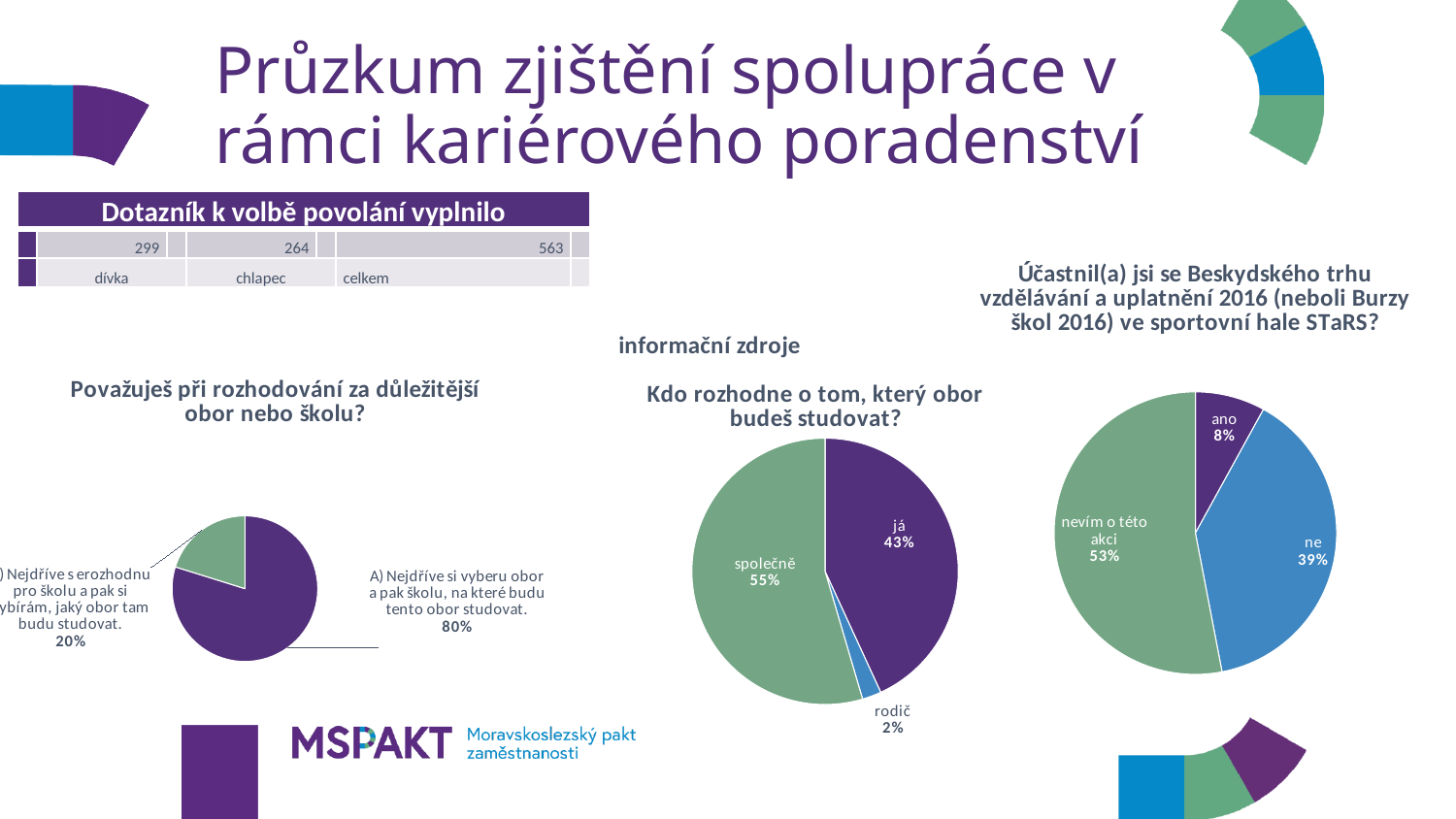
In the chart 'Kdo rozhodne o tom, který obor budeš studovat?', what share is labelled 'společně'? 55% In the chart 'Považuješ při rozhodování za důležitější obor nebo školu?', what share is given for option A (Nejdříve si vyberu obor a pak školu)? 80% What kind of chart is 'Kdo rozhodne o tom, který obor budeš studovat?'? pie chart In the chart 'Účastnil(a) jsi se Beskydského trhu vzdělávání a uplatnění 2016...', which category has the smallest share? ano In the chart 'Kdo rozhodne o tom, který obor budeš studovat?', what share is labelled 'rodič'? 2% In the chart 'Dotazník k volbě povolání vyplnilo', what is the difference between 'dívka' and 'chlapec'? 35 In the chart 'Považuješ při rozhodování za důležitější obor nebo školu?', which option has the larger share, A or B? A In the chart 'Účastnil(a) jsi se Beskydského trhu vzdělávání a uplatnění 2016...', how many slices does the pie have? 3 In the chart 'Kdo rozhodne o tom, který obor budeš studovat?', which category has the largest share? společně In the chart 'Účastnil(a) jsi se Beskydského trhu vzdělávání a uplatnění 2016...', what share answered 'ne'? 39% In the chart 'Kdo rozhodne o tom, který obor budeš studovat?', what is the difference between 'společně' and 'já'? 12% In the chart 'Dotazník k volbě povolání vyplnilo', what is the value for 'dívka'? 299